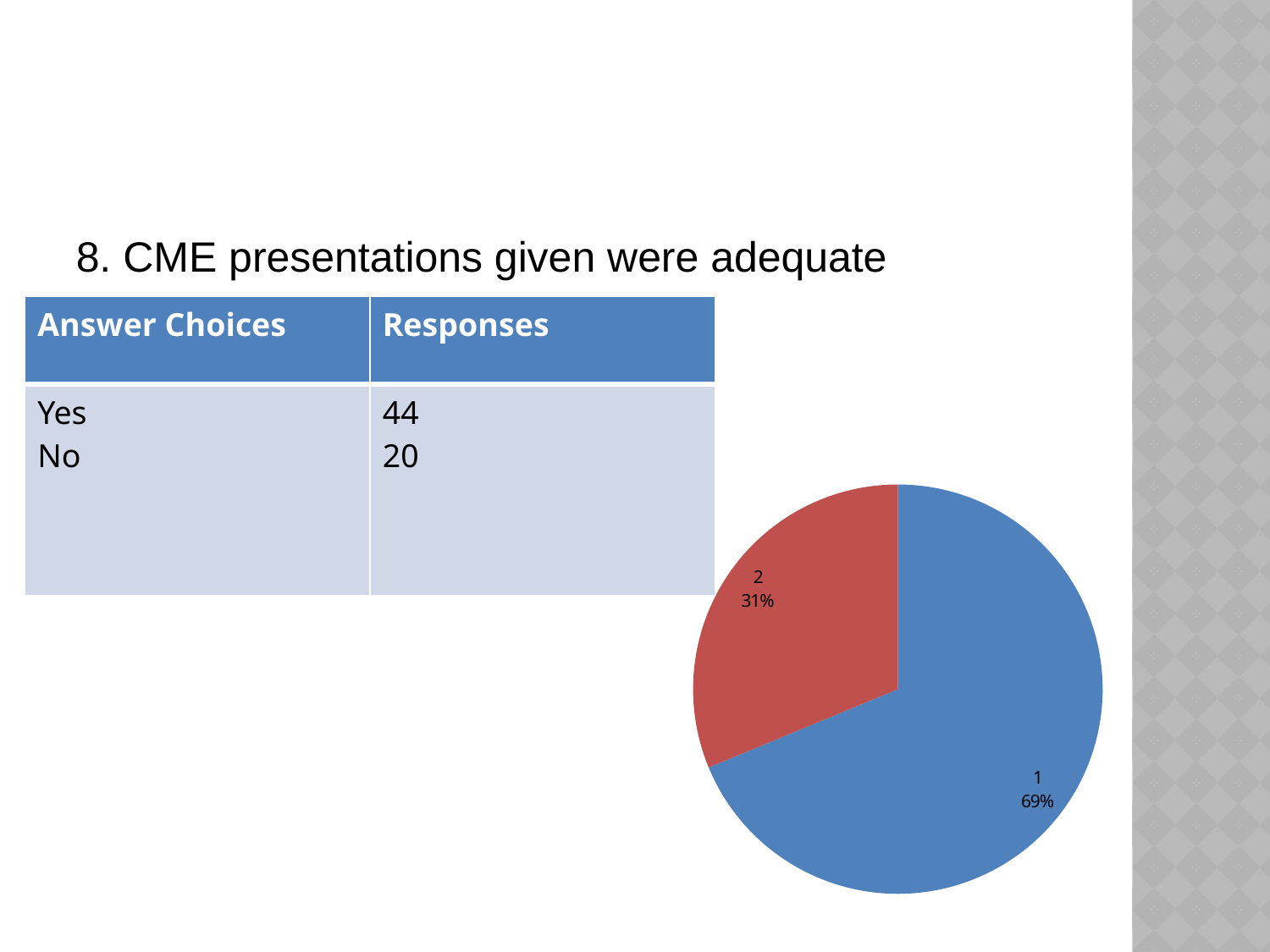
What colour is slice 2 in the pie chart? red What share of the pie does slice 2 represent? 31% Which slice of the pie chart is the largest? 1 Is the share for slice 2 greater or less than 50%? less By how many percentage points does slice 1 exceed slice 2? 38 What share of the pie does slice 1 represent? 69% What colour is slice 1 in the pie chart? blue Which slice of the pie chart is the smallest? 2 What kind of chart is shown on the slide? pie chart How many slices does the pie chart have? 2 Which slice is larger, slice 1 or slice 2? 1 Is the share for slice 1 greater or less than 50%? greater